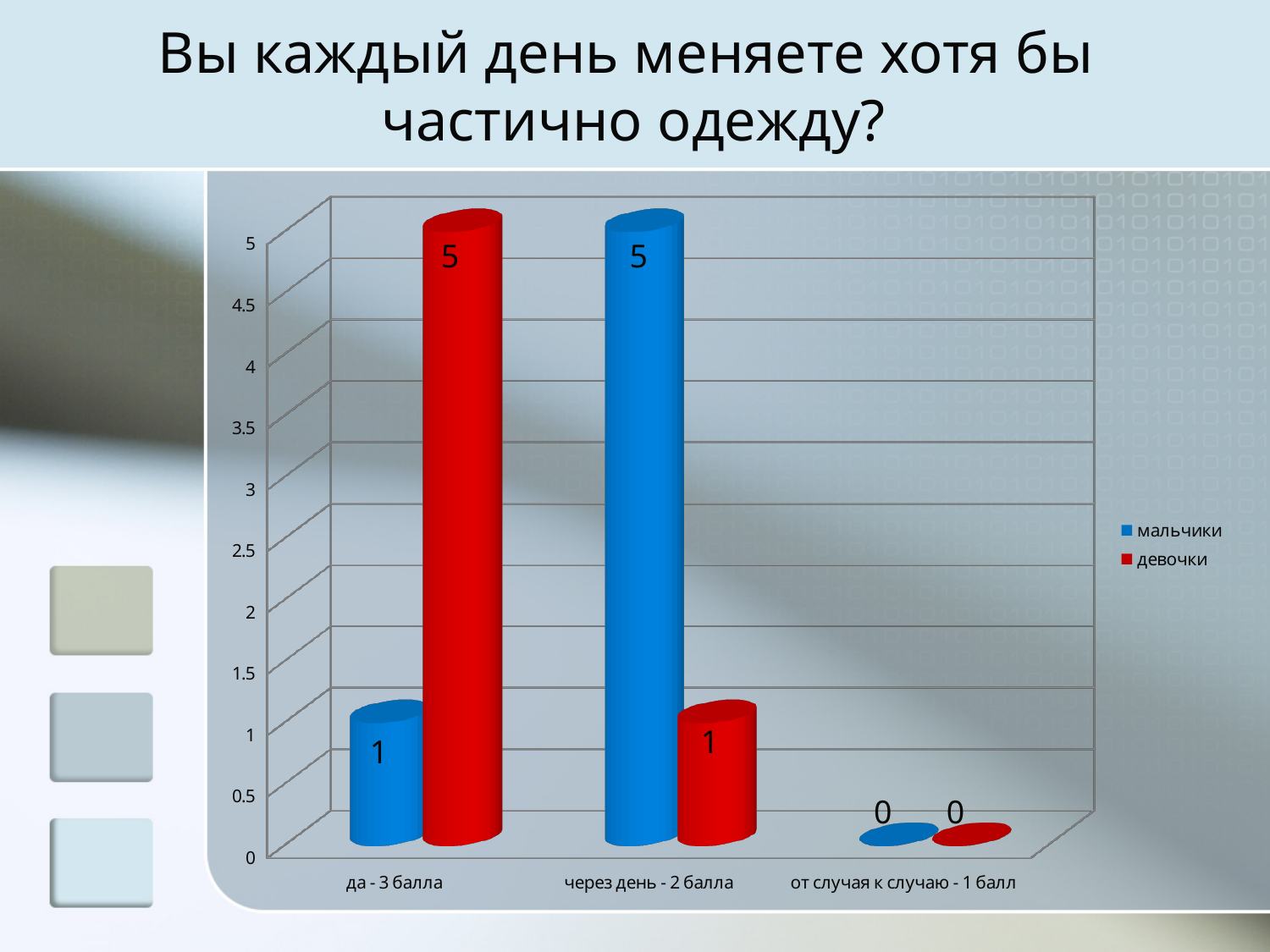
In which category is the value for мальчики highest? через день - 2 балла In the category 'через день - 2 балла', which series has the larger value, мальчики or девочки? мальчики In which category is the value for девочки lowest? от случая к случаю - 1 балл How many series does the legend list? 2 What value is shown for мальчики in the category 'да - 3 балла'? 1 What kind of chart is shown on the slide? bar chart Which colour represents девочки in the chart? red What value is shown for девочки in the category 'от случая к случаю - 1 балл'? 0 What value is shown for девочки in the category 'да - 3 балла'? 5 What is the difference between the девочки and мальчики values in the category 'да - 3 балла'? 4 What value is shown for мальчики in the category 'через день - 2 балла'? 5 How many categories are shown on the x axis? 3